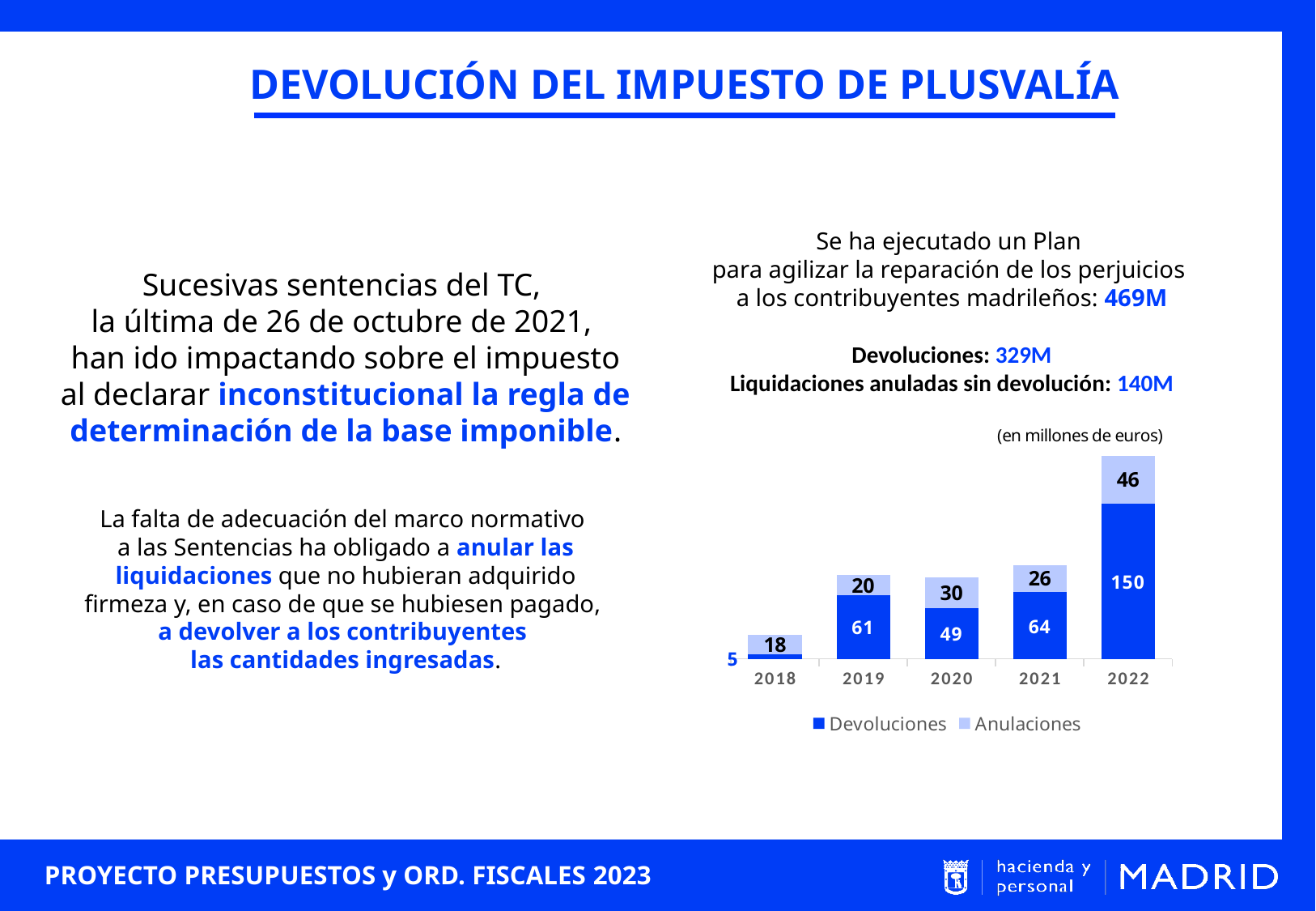
What unit is stated for the values in the chart? millones de euros How many series does the chart legend list? 2 How many years are shown on the x axis of the chart? 5 What is the total of the stacked bar for 2022? 196 Which year has the highest value of Devoluciones? 2022 What is the value of Devoluciones for 2022? 150 What is the difference between Devoluciones in 2022 and Devoluciones in 2021? 86 What is the value of Devoluciones for 2018? 5 Which year has the lowest value of Anulaciones? 2018 What is the value of Anulaciones for 2020? 30 Which is larger, Devoluciones in 2019 or Devoluciones in 2020? Devoluciones in 2019 What type of chart is shown on the slide? stacked bar chart